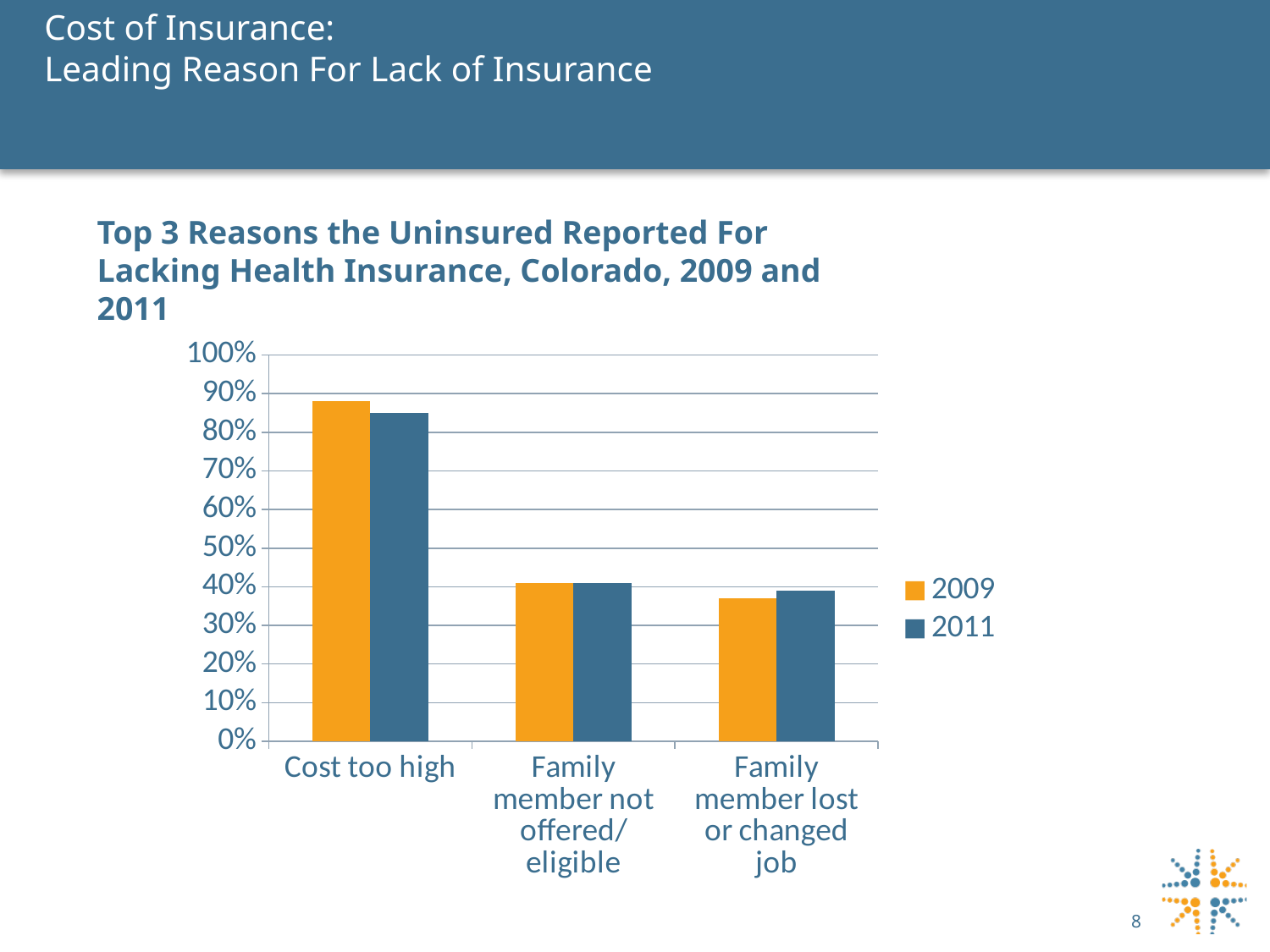
How many series does the chart's legend list? 2 Is the 2011 value for Cost too high greater or less than 80%? greater What kind of chart is shown on the slide? bar chart Is the 2009 value for Cost too high greater or less than 80%? greater Is the 2009 value for Family member lost or changed job greater or less than 40%? less How many categories are shown on the x axis of the chart? 3 Which category has the lowest value for 2009? Family member lost or changed job Which category has the highest value for 2011? Cost too high For Cost too high, which year has the larger value, 2009 or 2011? 2009 Which two years does the chart's legend list? 2009 and 2011 Which category has the highest value for 2009? Cost too high